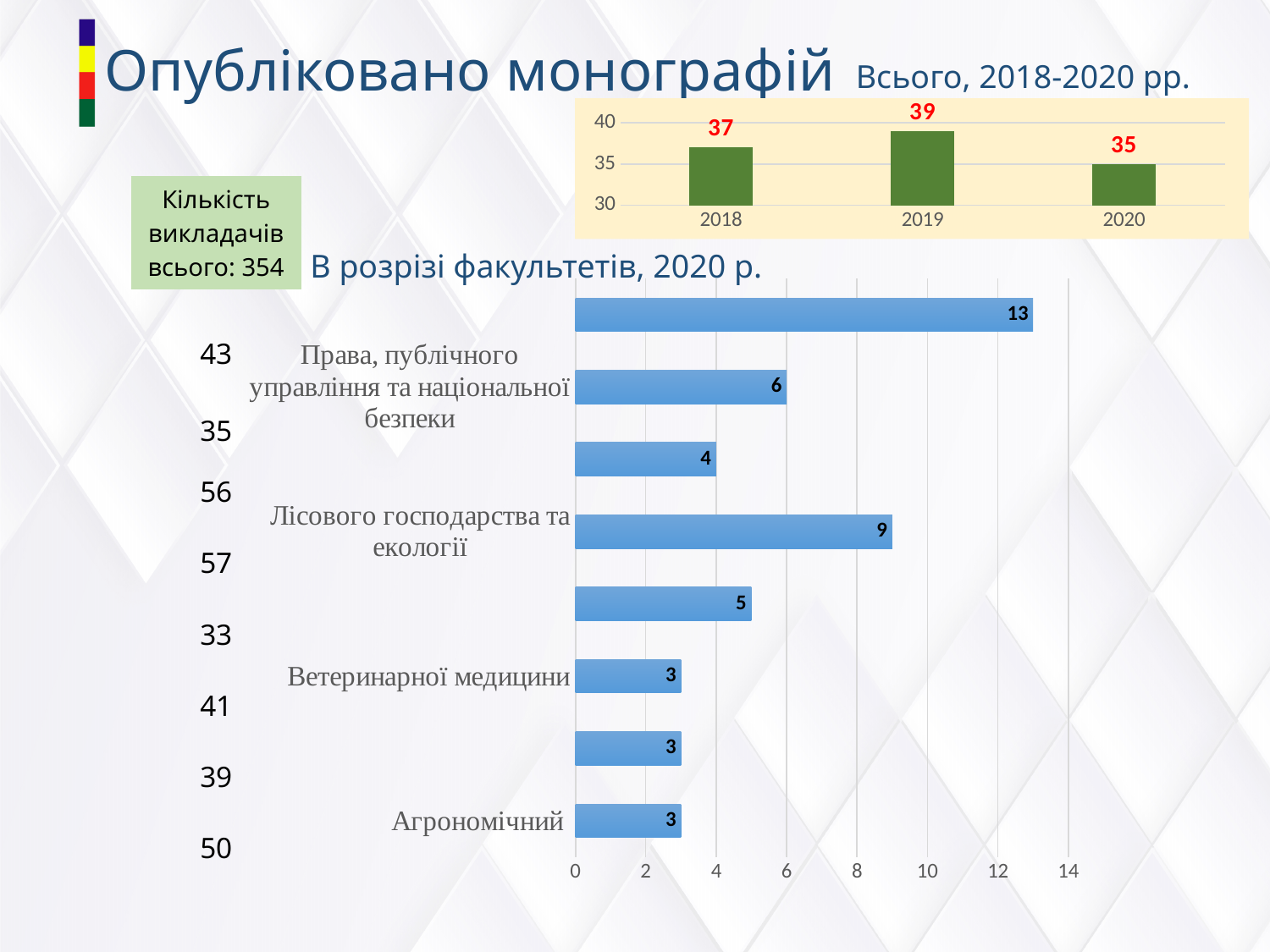
In the chart 'В розрізі факультетів, 2020 р.', what is the highest value shown on any bar? 13 In the chart 'Всього, 2018-2020 рр.', which year has the lowest value? 2020 In the chart 'В розрізі факультетів, 2020 р.', what is the value for 'Лісового господарства та екології'? 9 In the chart 'Всього, 2018-2020 рр.', what is the difference between the values for 2019 and 2020? 4 In the chart 'В розрізі факультетів, 2020 р.', what is the value for 'Права, публічного управління та національної безпеки'? 6 In the chart 'Всього, 2018-2020 рр.', is the value for 2018 greater or less than 35? greater What type of chart is 'В розрізі факультетів, 2020 р.'? bar chart In the chart 'В розрізі факультетів, 2020 р.', what is the value for 'Агрономічний'? 3 In the chart 'В розрізі факультетів, 2020 р.', how many bars are there? 8 In the chart 'Всього, 2018-2020 рр.', how many years are shown? 3 In the chart 'Всього, 2018-2020 рр.', what is the value for 2019? 39 In the chart 'В розрізі факультетів, 2020 р.', which is larger: the value for 'Лісового господарства та екології' or the value for 'Ветеринарної медицини'? Лісового господарства та екології